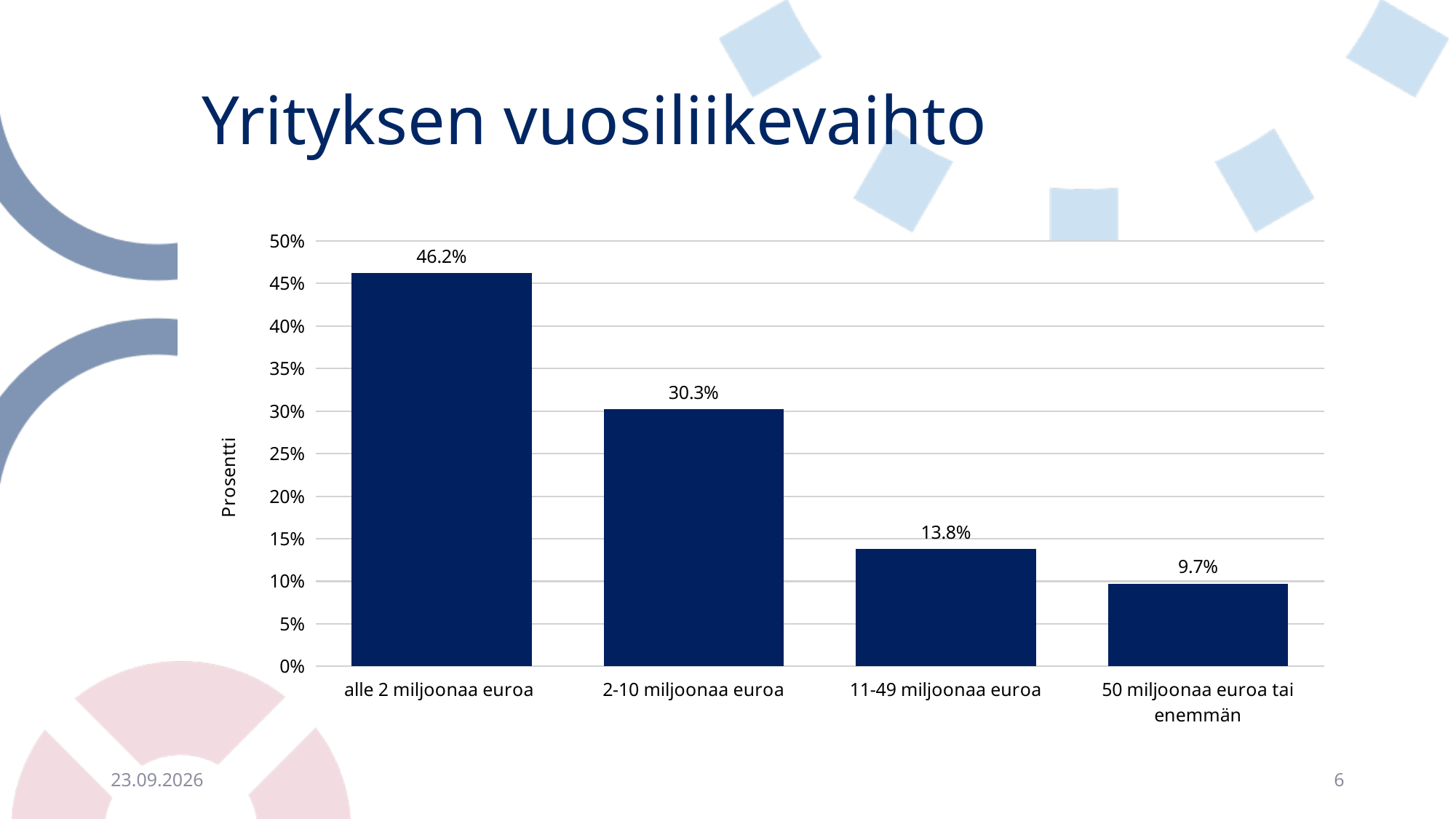
How many categories are shown on the x axis? 4 Which category has the lowest value? 50 miljoonaa euroa tai enemmän Which category has the highest value? alle 2 miljoonaa euroa Which is larger: the value for "11-49 miljoonaa euroa" or "50 miljoonaa euroa tai enemmän"? 11-49 miljoonaa euroa What is the difference between the values for "alle 2 miljoonaa euroa" and "2-10 miljoonaa euroa"? 15.9% What is the value for "11-49 miljoonaa euroa"? 13.8% What is the label of the y axis? Prosentti What is the value for "alle 2 miljoonaa euroa"? 46.2% What kind of chart is shown on the slide? bar chart What is the value for "50 miljoonaa euroa tai enemmän"? 9.7% What is the value for "2-10 miljoonaa euroa"? 30.3% Is the value for "2-10 miljoonaa euroa" greater or less than 25%? greater